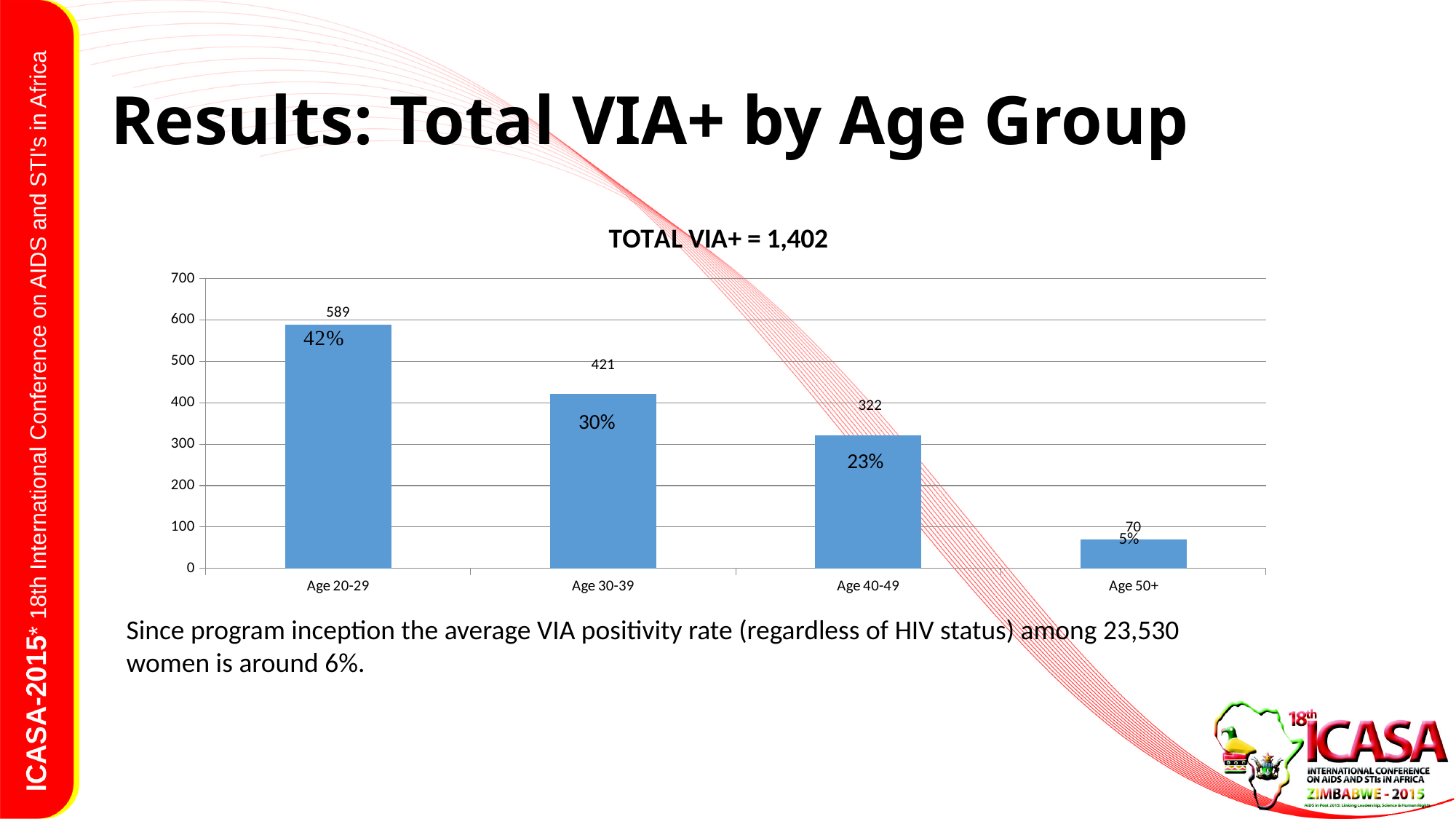
Do the values rise or fall from Age 20-29 to Age 50+? Fall What percentage label is shown on the bar for Age 40-49? 23% What is the value for Age 50+? 70 Which age group has the highest value? Age 20-29 Which age group has the lowest value? Age 50+ Which is larger, the value for Age 30-39 or Age 40-49? Age 30-39 What is the value for Age 30-39? 421 What kind of chart is shown on the slide? Bar chart What is the value for Age 20-29? 589 What is the value for Age 40-49? 322 What is the difference between the values for Age 20-29 and Age 30-39? 168 How many age groups are shown in the chart? 4